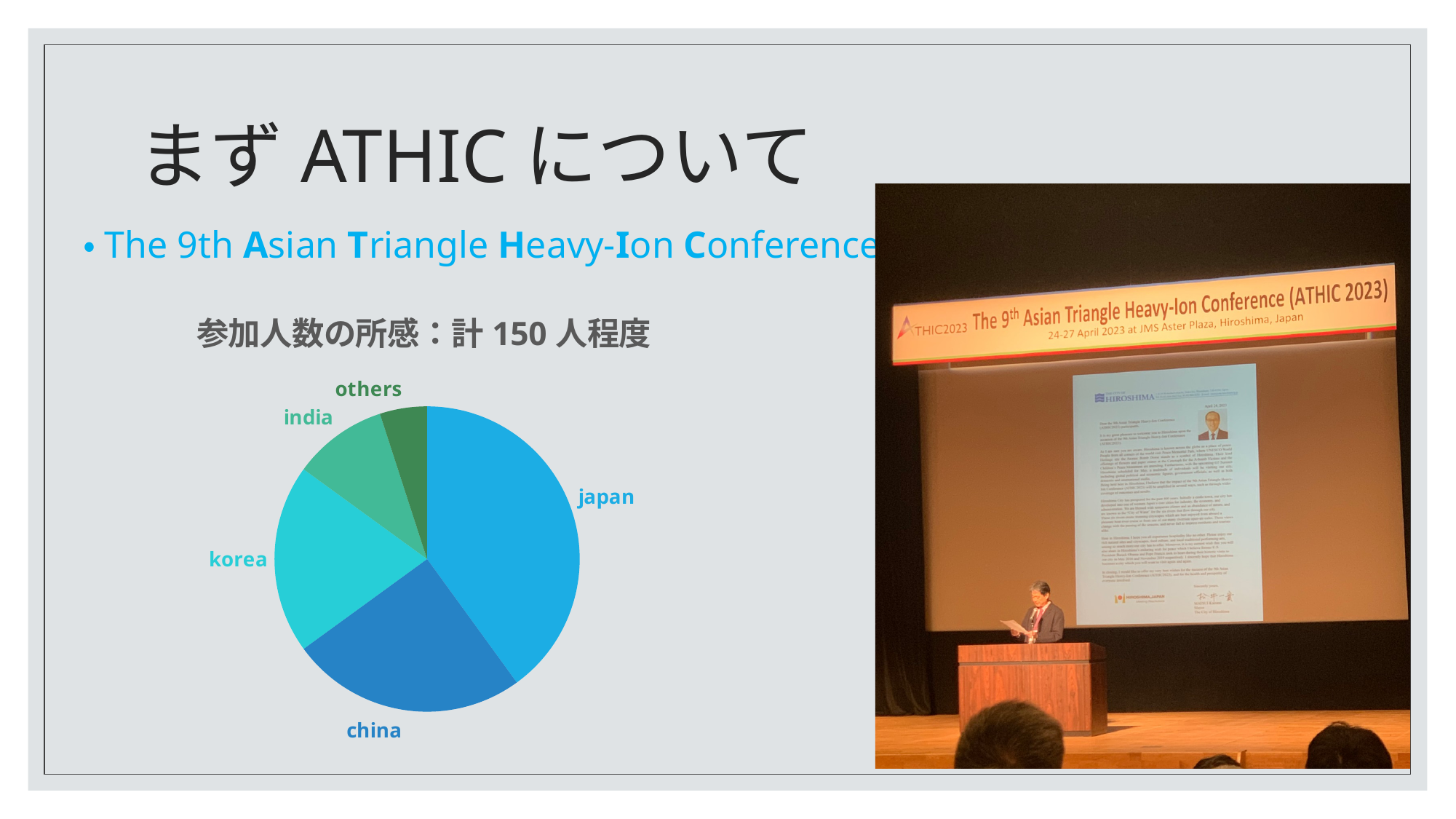
What kind of chart is shown on the slide? pie chart Which category has the smallest slice in the pie chart? others Which category has the largest slice in the pie chart? japan Which slice is larger in the pie chart, korea or india? korea Which slice is larger in the pie chart, japan or korea? japan Which slice is larger in the pie chart, japan or china? japan How many slices does the pie chart have? 5 What colour is the japan slice in the pie chart? blue What is the title shown above the pie chart? 参加人数の所感：計 150 人程度